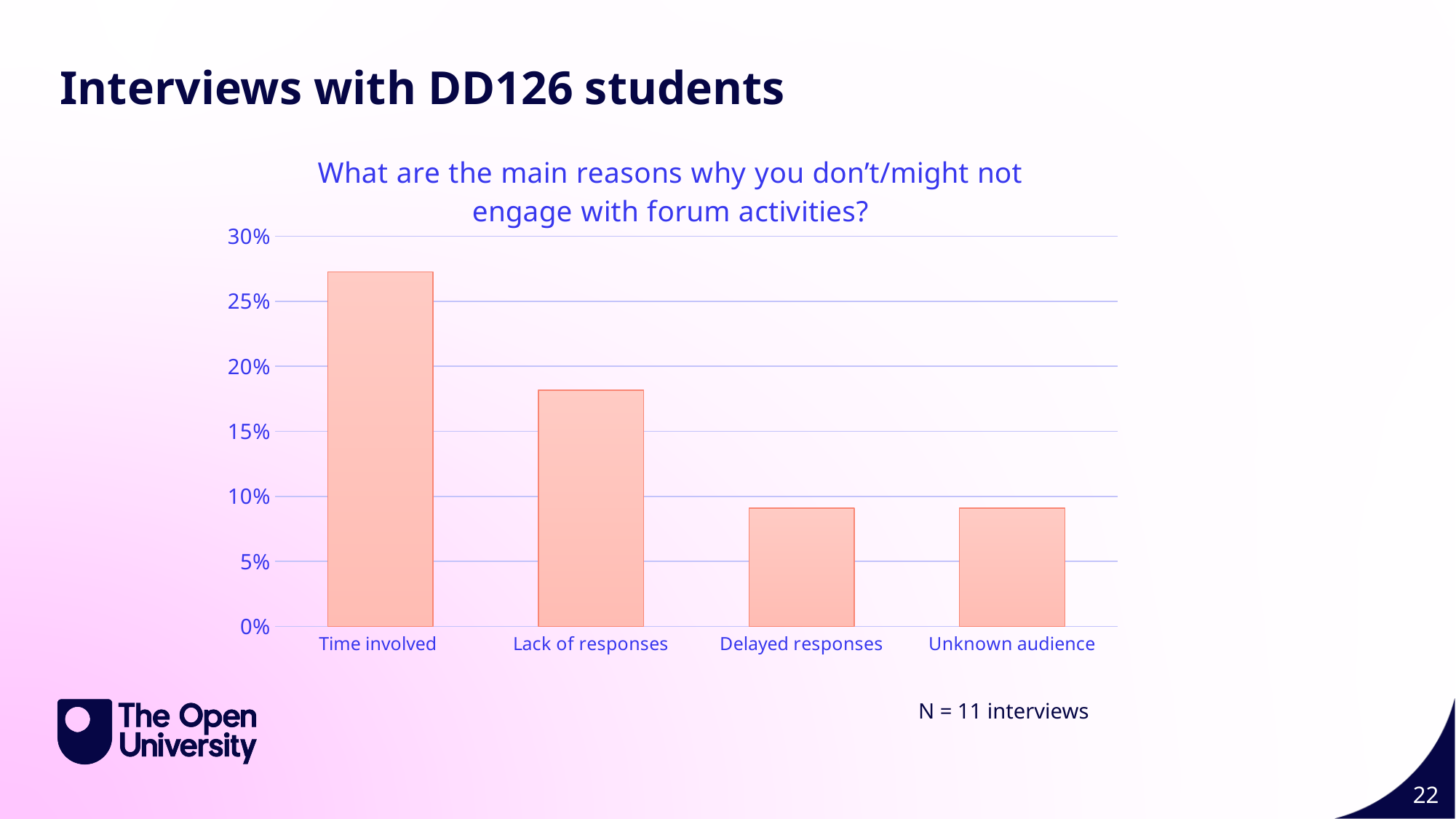
Is the value for Unknown audience greater or less than 5%? greater What is the title of the chart? What are the main reasons why you don't/might not engage with forum activities? What is the highest value shown on the y axis of the chart? 30% What type of chart is shown on the slide? bar chart Is the value for Time involved greater or less than 25%? greater Which category has the highest value in the chart? Time involved How many categories are shown on the x axis of the chart? 4 Is the value for Lack of responses greater or less than 20%? less Do the bar values generally rise or fall from left to right along the x axis? fall Which is larger, the value for Time involved or the value for Lack of responses? Time involved